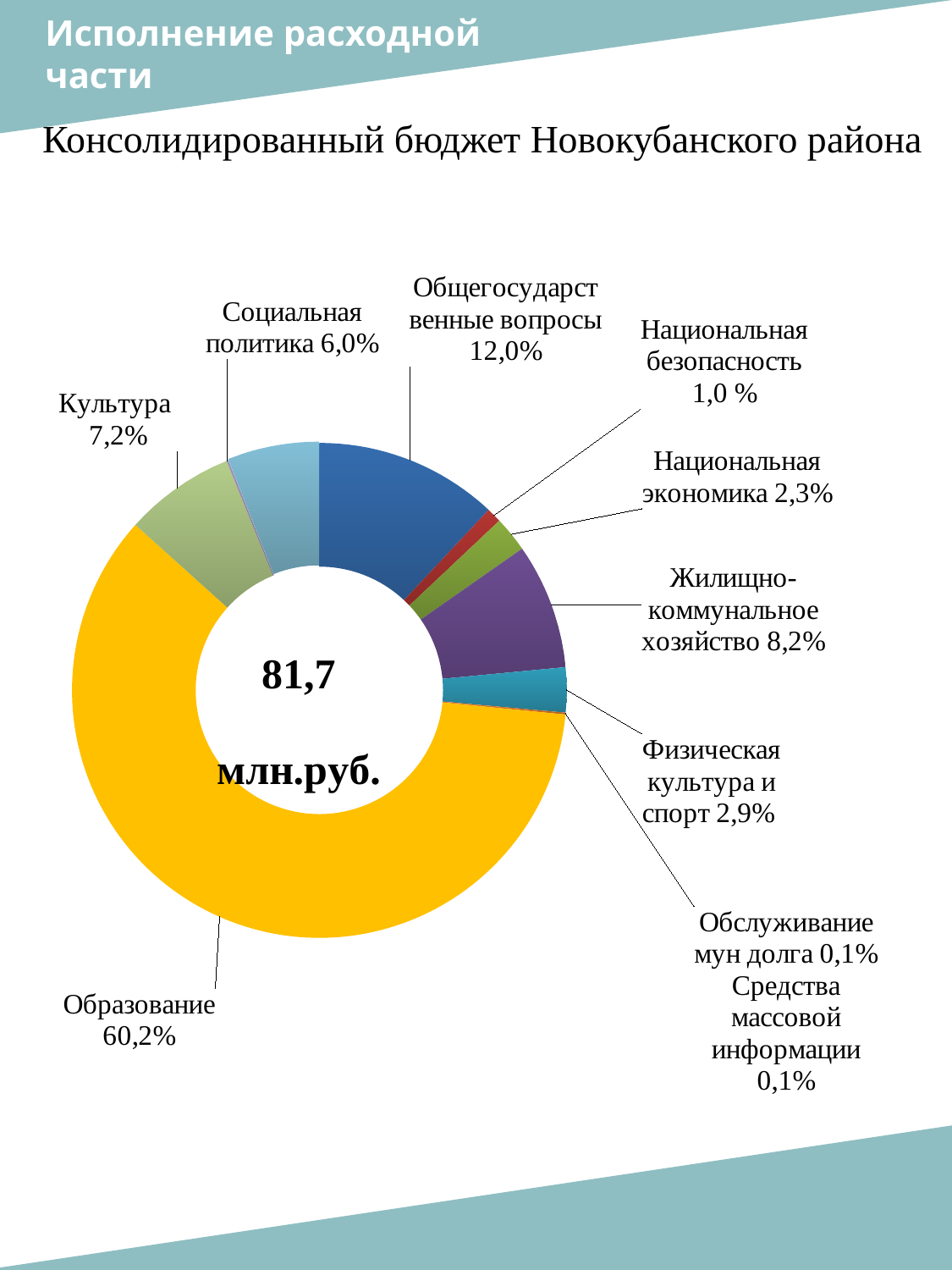
What is the difference in percentage points between Общегосударственные вопросы and Культура? 4,8 What share of the budget goes to Образование? 60,2% What total value is printed in the centre of the chart? 81,7 млн.руб. Which is larger, the share for Культура or the share for Социальная политика? Культура What is the combined share of Обслуживание мун долга and Средства массовой информации? 0,2% Which is larger, the share for Национальная экономика or the share for Физическая культура и спорт? Физическая культура и спорт What percentage is shown for Жилищно-коммунальное хозяйство? 8,2% What percentage is shown for Физическая культура и спорт? 2,9% How many categories are shown in the chart? 10 Which category has the largest share of the chart? Образование What kind of chart is shown on the slide? Doughnut (pie) chart What share is labelled for Общегосударственные вопросы? 12,0%